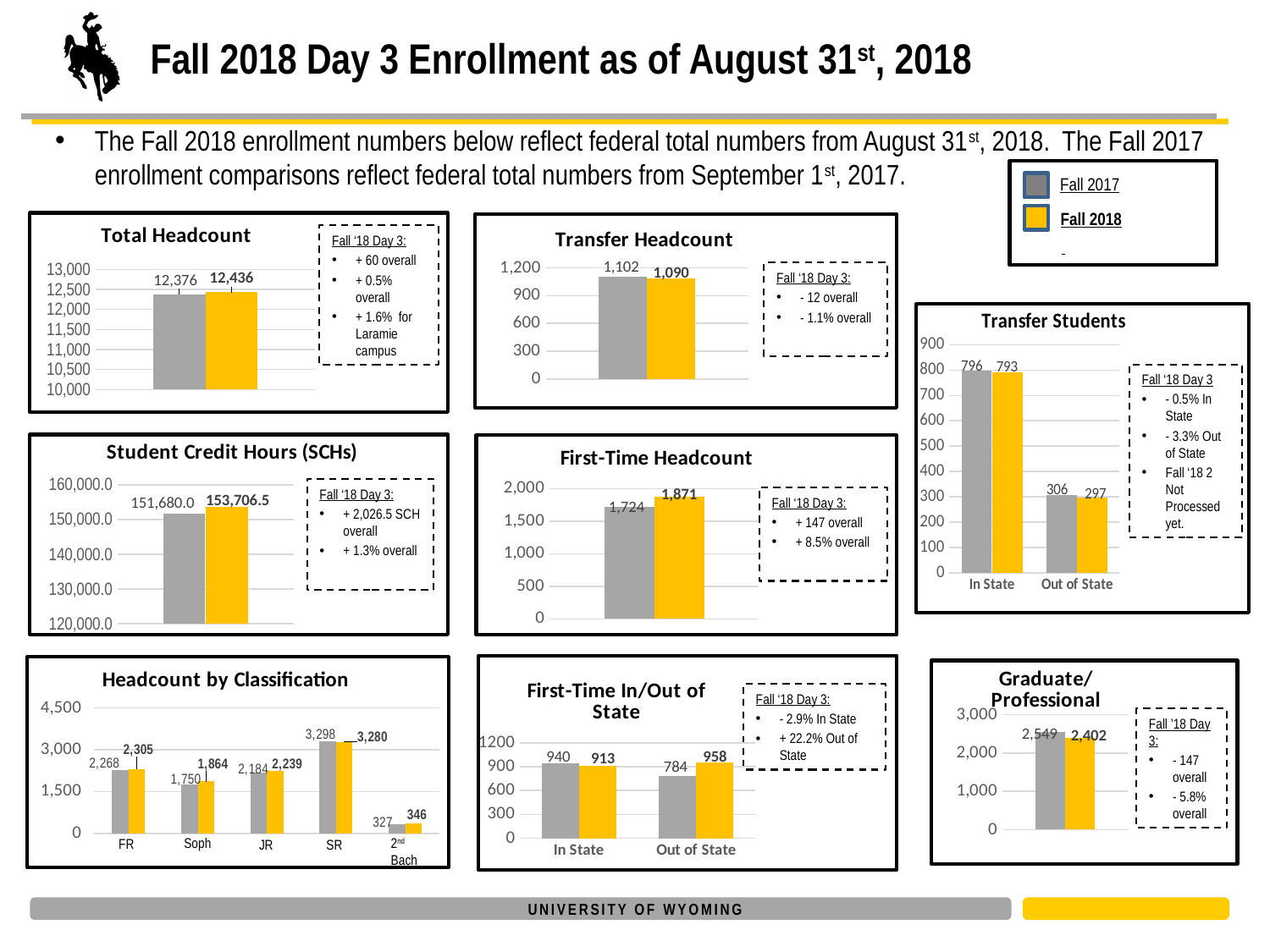
In the Transfer Headcount chart, what is the Fall 2017 value? 1,102 In the Student Credit Hours (SCHs) chart, what is the Fall 2018 value? 153,706.5 In the Headcount by Classification chart, which classification has the highest Fall 2018 headcount? SR In the Total Headcount chart, what is the Fall 2018 value? 12,436 In the Transfer Students chart, what is the Fall 2018 value for Out of State? 297 How many classification categories are shown on the x axis of the Headcount by Classification chart? 5 In the First-Time Headcount chart, what is the difference between the Fall 2018 and Fall 2017 values? 147 In the Total Headcount chart, what is the difference between the Fall 2018 and Fall 2017 values? 60 In the Graduate/Professional chart, what is the Fall 2017 value? 2,549 In the Headcount by Classification chart, what is the Fall 2017 value for Soph? 1,750 In the Transfer Headcount chart, which is larger, the Fall 2017 or the Fall 2018 value? Fall 2017 In the First-Time In/Out of State chart, what is the Fall 2018 value for Out of State? 958